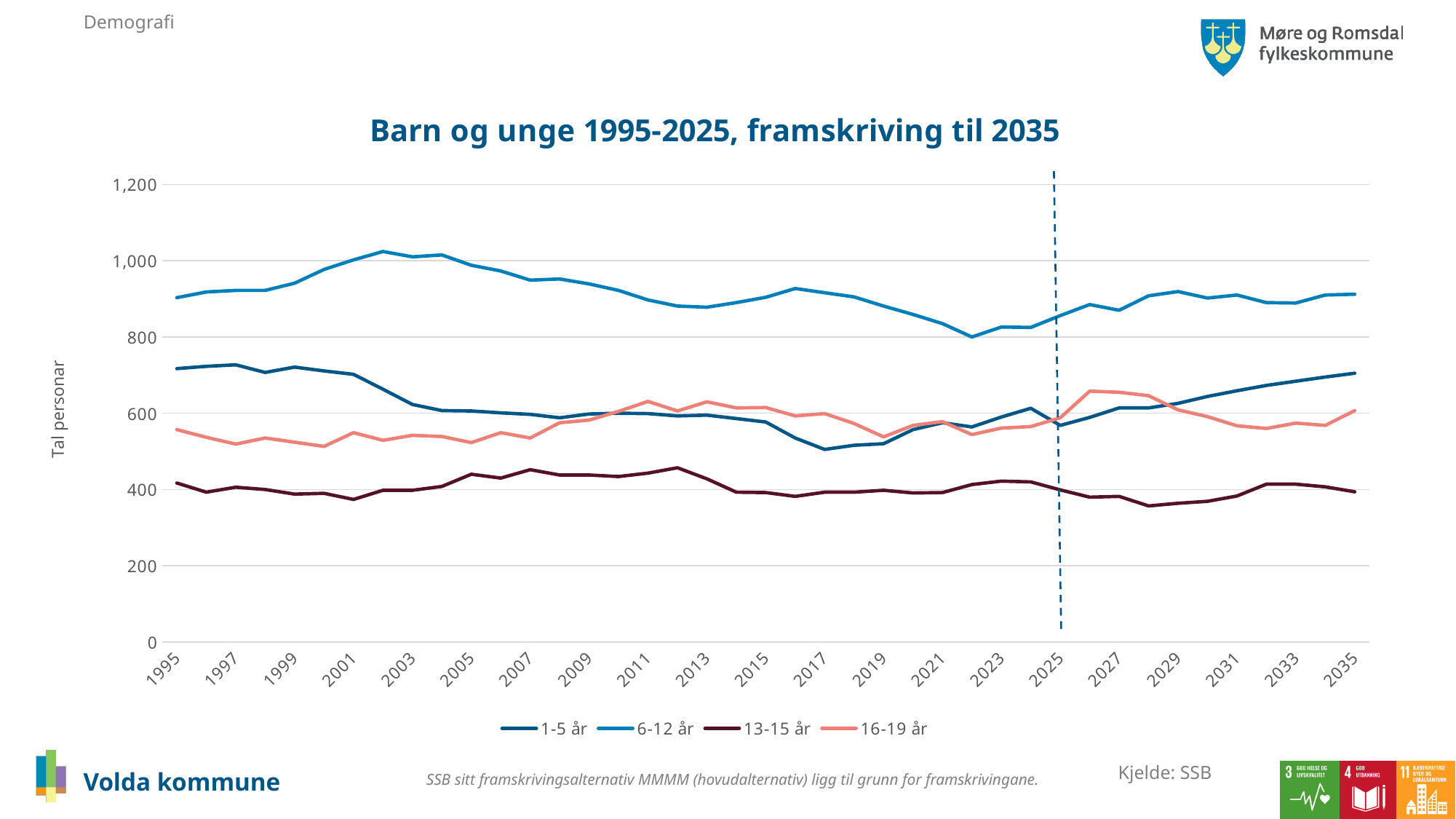
Does the 1-5 år series rise or fall between 2025 and 2035? Rises Which series has the highest value in 2035? 6-12 år What kind of chart is shown on the slide? Line chart Which series has the lowest value in 1995? 13-15 år How many series does the legend list? 4 What is the label on the y axis? Tal personar Is the value for 13-15 år in 2028 greater or less than 400? less In 1995, which is larger: the value for 1-5 år or the value for 16-19 år? 1-5 år What is the title of the chart? Barn og unge 1995-2025, framskriving til 2035 Is the value for 16-19 år in 1995 greater or less than 600? less Is the value for 6-12 år in 2002 greater or less than 1,000? greater How many year labels are shown on the x axis? 21